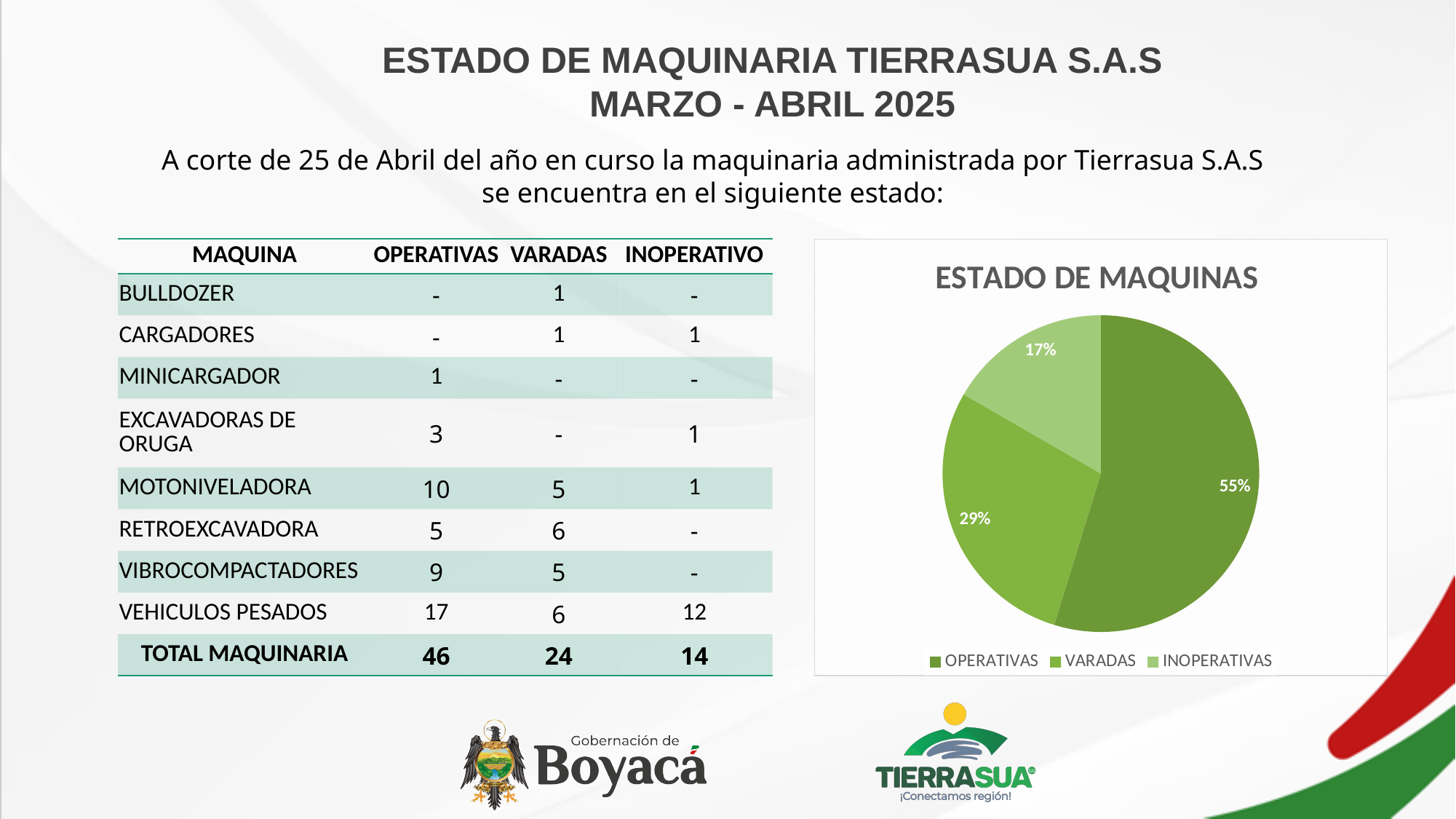
Which category has the largest slice in the pie chart? OPERATIVAS What kind of chart is shown on the slide? pie chart How many slices does the pie chart have? 3 What is the title of the pie chart? ESTADO DE MAQUINAS What share of the pie chart is INOPERATIVAS? 17% By how many percentage points does the OPERATIVAS share exceed the VARADAS share in the pie chart? 26 Which legend entry of the pie chart is shown in the lightest green? INOPERATIVAS What share of the pie chart is OPERATIVAS? 55% What share of the pie chart is VARADAS? 29% Which slice is larger in the pie chart, VARADAS or INOPERATIVAS? VARADAS How many entries does the legend of the pie chart list? 3 Which category has the smallest slice in the pie chart? INOPERATIVAS